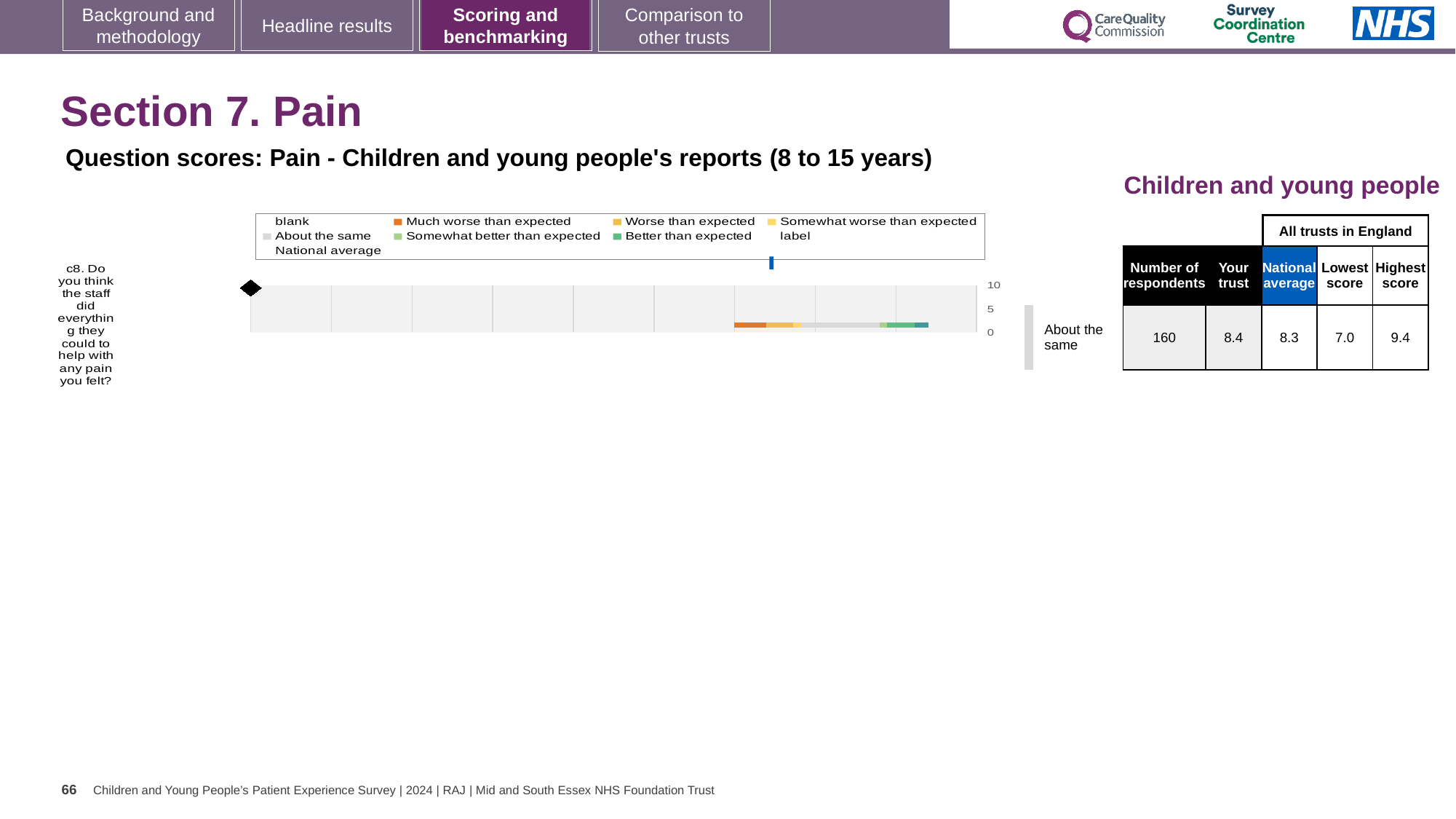
How many survey questions are plotted on the chart? 1 Which is larger for question c8: the 'Your trust' score or the National average? Your trust What kind of chart is shown on the slide? bar chart How many respondents answered question c8? 160 What is the 'Your trust' score for question c8 in the table beside the chart? 8.4 Which legend entry is shown in orange? Much worse than expected What is the difference between the Highest score and the Lowest score for question c8? 2.4 What is the highest value shown on the chart's numeric axis? 10 What is the Highest score across all trusts in England for question c8? 9.4 What is the National average score for question c8 in the table beside the chart? 8.3 What is the difference between the 'Your trust' score and the National average for question c8? 0.1 What is the Lowest score across all trusts in England for question c8? 7.0